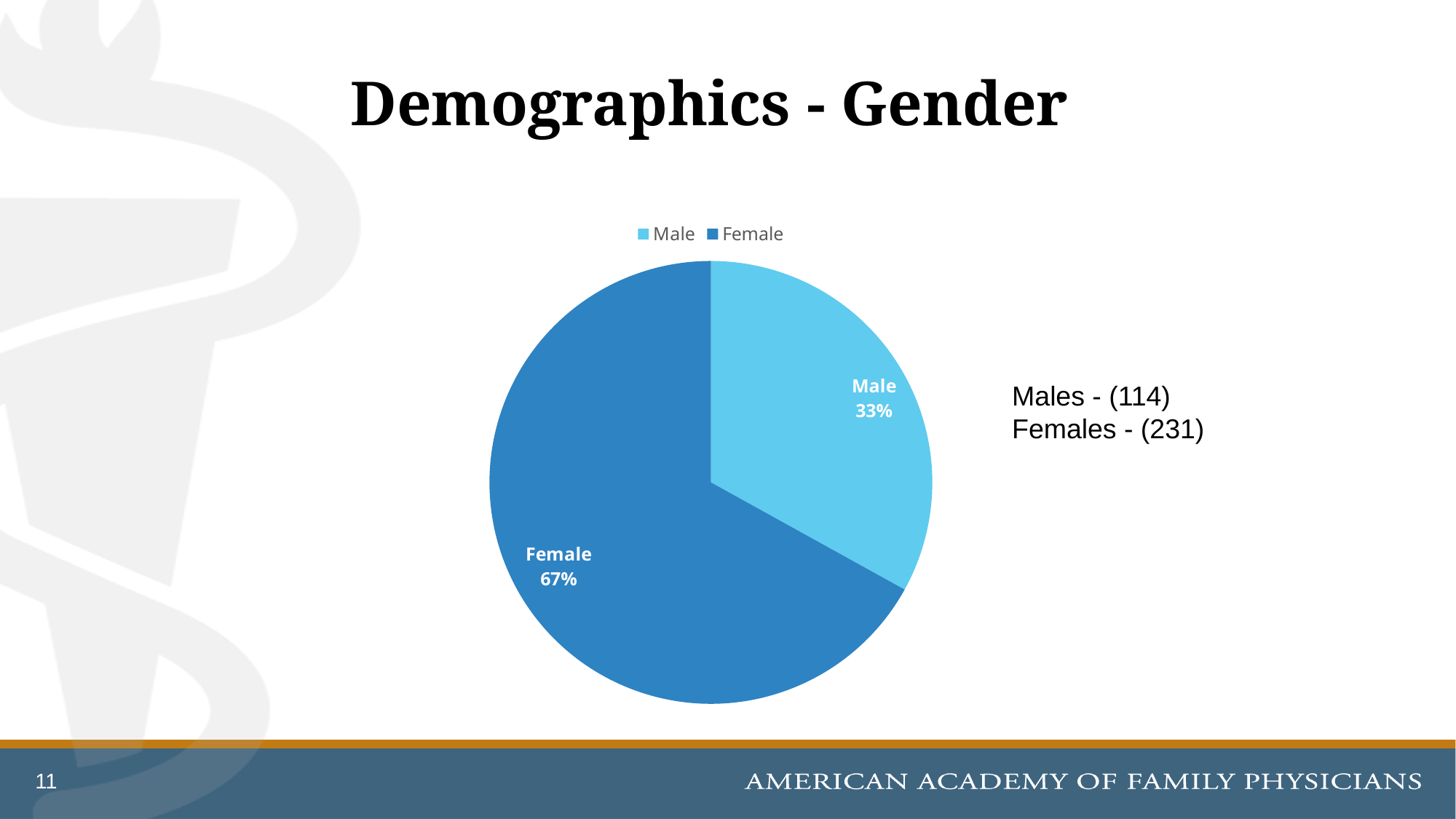
What share of the pie does the Female slice represent? 67% Which is larger, the Male slice or the Female slice? Female What is the title of the slide containing the pie chart? Demographics - Gender Which slice of the pie is the smallest? Male Which slice of the pie is the largest? Female What is the difference in percentage points between the Female and Male slices? 34 Which legend entry is shown in the lighter blue colour? Male What kind of chart is shown on the slide? pie chart How many entries does the legend list? 2 What percentage of the pie is labelled Male? 33% What percentage of the pie is labelled Female? 67% How many slices does the pie chart have? 2